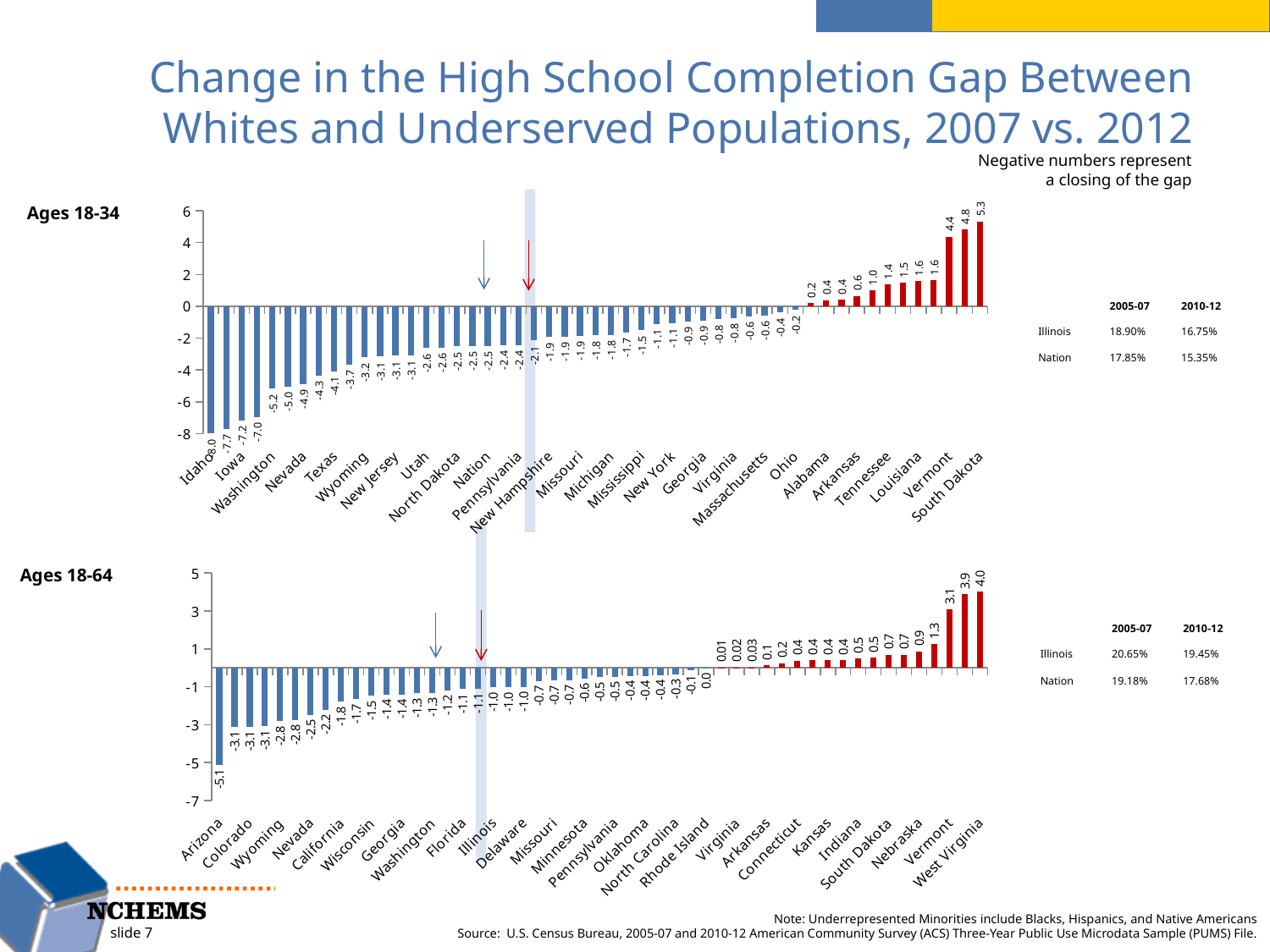
What kind of chart is the Ages 18-64 chart? bar chart In the Ages 18-64 chart, what is the value for West Virginia? 4.0 In the Ages 18-64 chart, what is the value for Arizona? -5.1 In the Ages 18-64 chart, is the value for West Virginia greater or less than 3? greater In the Ages 18-34 chart, what is the value for Idaho? -8.0 In the Ages 18-34 chart, what is the value for South Dakota? 5.3 In the Ages 18-34 chart, do the values rise or fall moving from left to right along the x axis? rise In the Ages 18-34 chart, what is the difference between the values for South Dakota and Idaho? 13.3 In the Ages 18-64 chart, which state has the lowest value? Arizona In the table next to the Ages 18-34 chart, what is the Illinois value for 2005-07? 18.90% In the Ages 18-34 chart, which state has the highest value? South Dakota According to the note on the slide, what do negative numbers represent? a closing of the gap